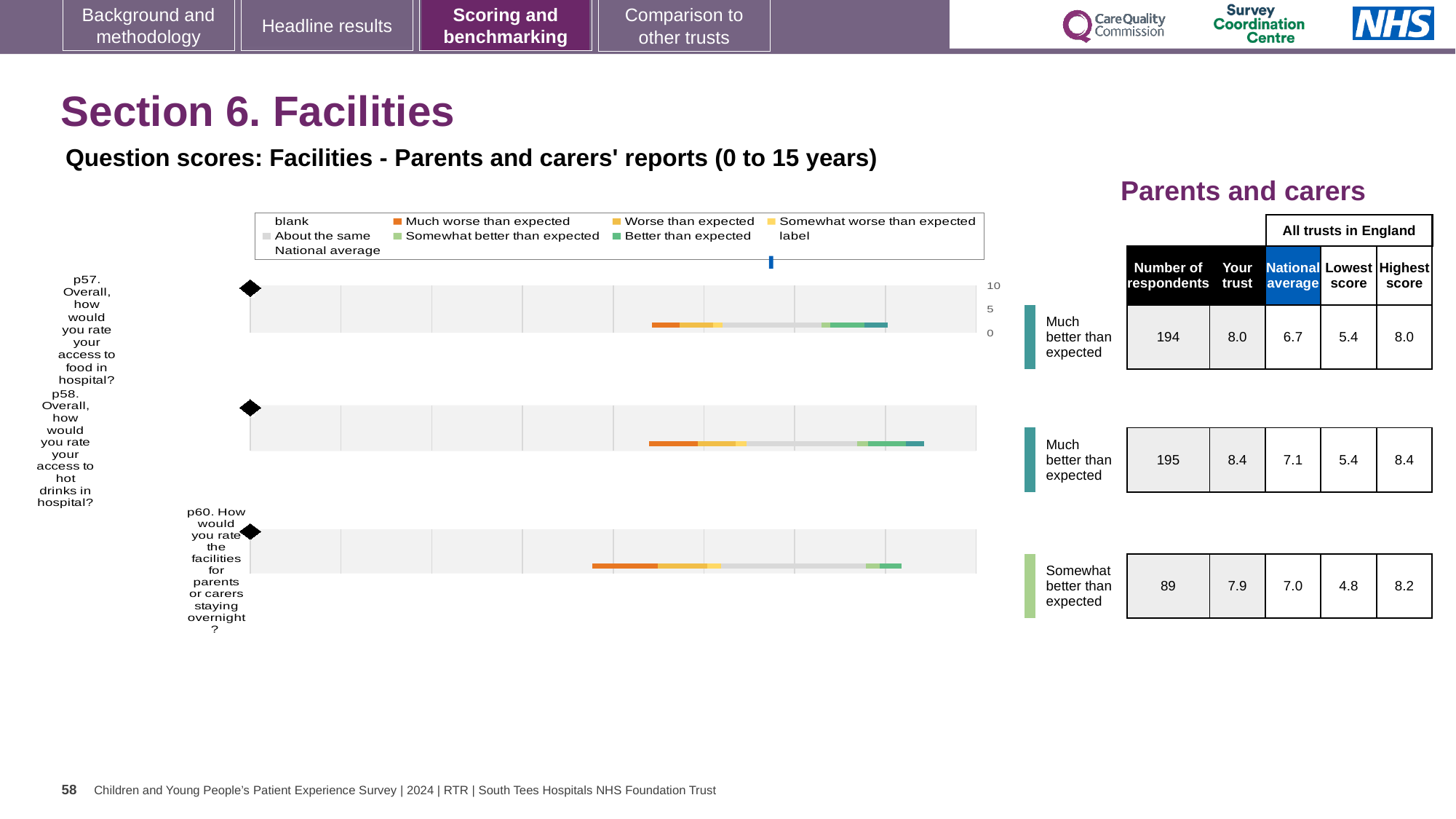
According to the table, what is the 'Your trust' score for p57 (access to food in hospital)? 8.0 For p60, is the 'Your trust' score higher or lower than the national average? higher In the chart legend, which colour represents 'Much worse than expected'? orange Which question has the highest 'Your trust' score in the table? p58 What kind of chart is shown on the slide? bar chart How many survey questions (categories) are plotted in the chart? 3 Which question has the fewest respondents in the table? p60 According to the table, what is the lowest score among all trusts in England for p60? 4.8 According to the table, what is the national average score for p58 (access to hot drinks in hospital)? 7.1 According to the table, how many respondents answered p60 (facilities for parents or carers staying overnight)? 89 What is the highest tick value shown on the chart's score axis? 10 What is the difference between the 'Your trust' score and the national average for p57? 1.3